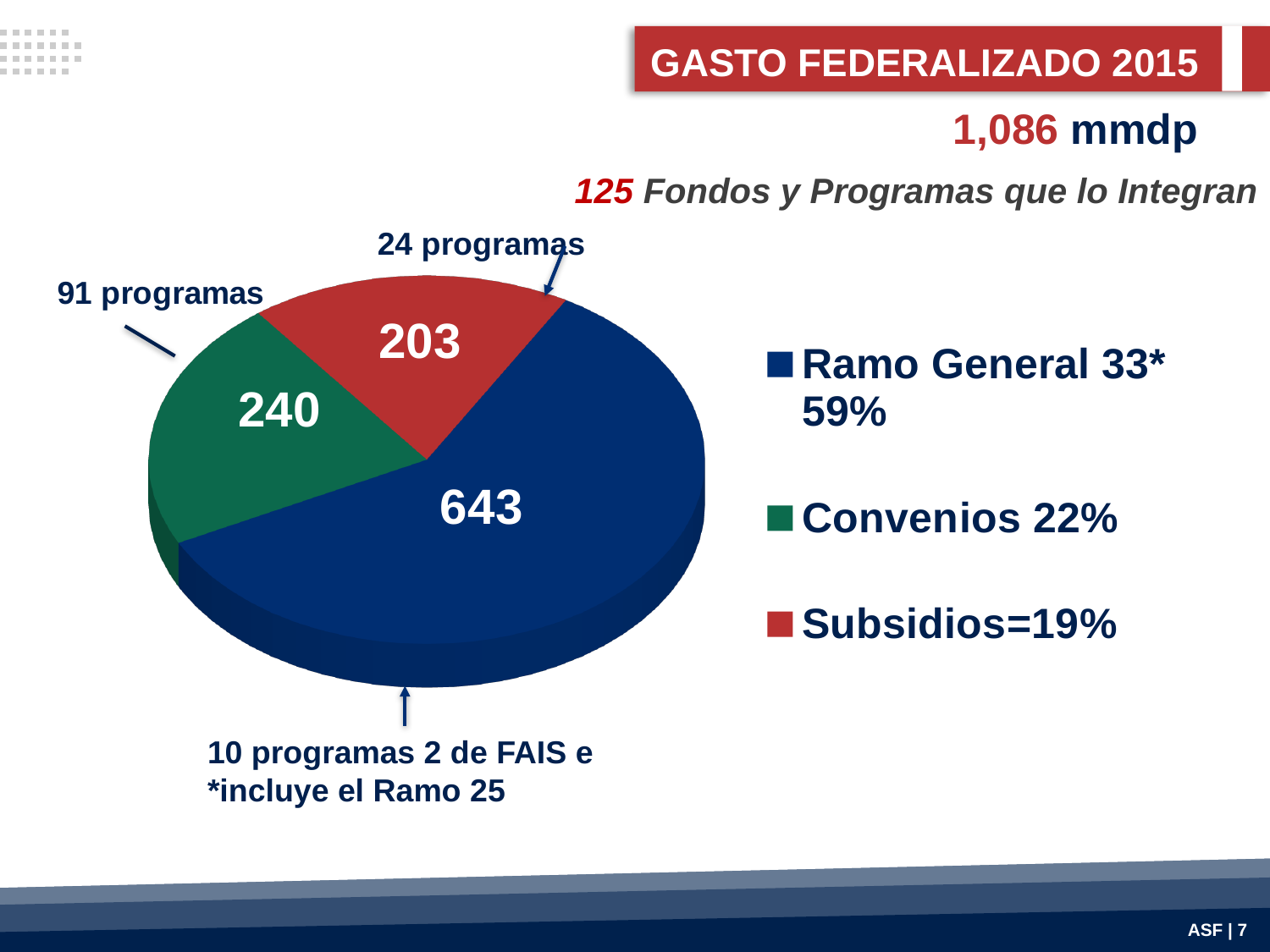
What is the difference between the Ramo General 33* value and the Convenios value? 403 What is the value of the Convenios slice? 240 What share of the pie does Ramo General 33* represent? 59% What share of the pie does Convenios represent? 22% What is the value of the Subsidios slice? 203 How many entries does the legend list? 3 What type of chart is shown on the slide? pie chart Which slice of the pie chart is the smallest? Subsidios Which is larger, the Convenios slice or the Subsidios slice? Convenios What is the value of the Ramo General 33* slice? 643 How many slices does the pie chart have? 3 Which slice of the pie chart is the largest? Ramo General 33*